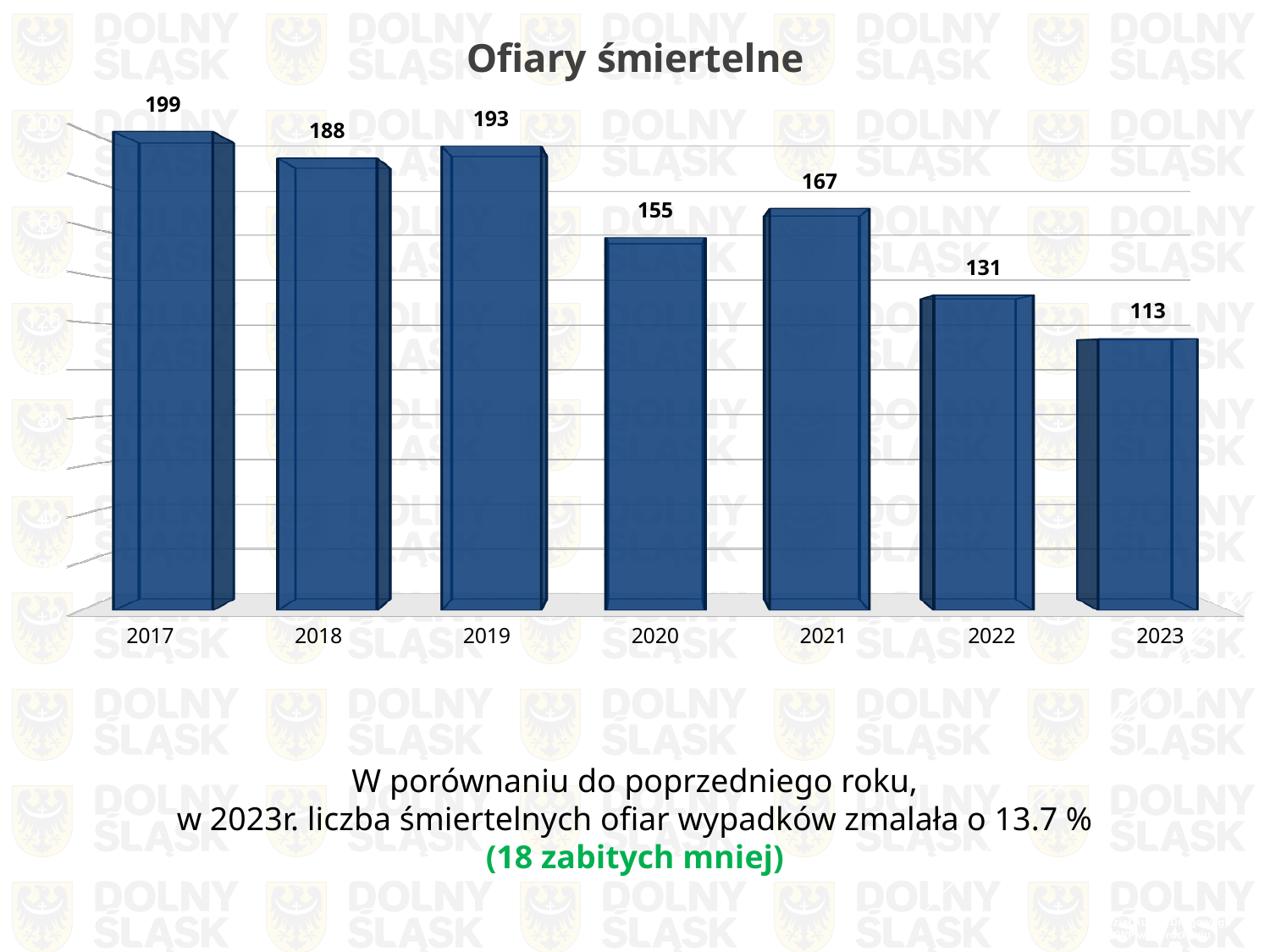
Do the values generally rise or fall from 2017 to 2023? fall Which year has the lowest value? 2023 Which year has the highest value? 2017 What is the difference between the values for 2022 and 2023? 18 What is the value for 2023? 113 What is the title of the chart? Ofiary śmiertelne What is the difference between the values for 2017 and 2019? 6 Which is larger, the value for 2018 or the value for 2021? 2018 What is the value for 2020? 155 What is the value for 2017? 199 How many years are shown on the x axis? 7 What kind of chart is this? bar chart